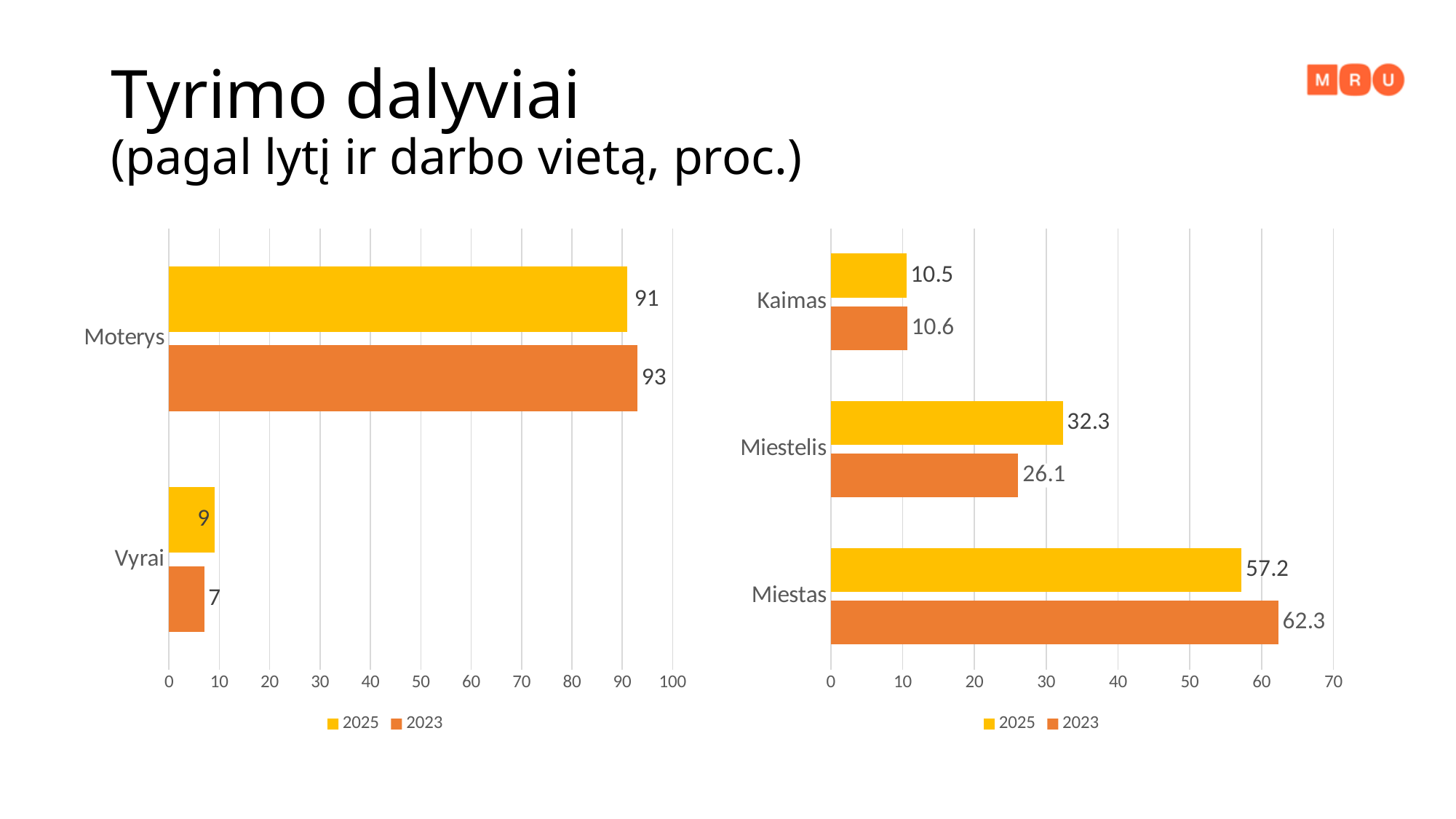
In the right chart (workplace), what is the difference between the 2025 and 2023 values for Miestelis? 6.2 In the left chart (gender), what is the difference between the 2023 and 2025 values for Moterys? 2 In the left chart (gender), what type of chart is shown? Bar chart In the left chart (gender), which category has the highest value in 2025? Moterys In the right chart (workplace), how many series does the legend list? 2 In the right chart (workplace), how many categories are shown? 3 In the right chart (workplace), what is the value for Miestelis in 2025? 32.3 In the right chart (workplace), which is larger for Miestas: the 2025 value or the 2023 value? 2023 In the right chart (workplace), which category has the lowest value in 2025? Kaimas In the left chart (gender), what is the value for Vyrai in 2023? 7 In the left chart (gender), what is the value for Moterys in 2025? 91 In the right chart (workplace), what is the value for Miestas in 2023? 62.3